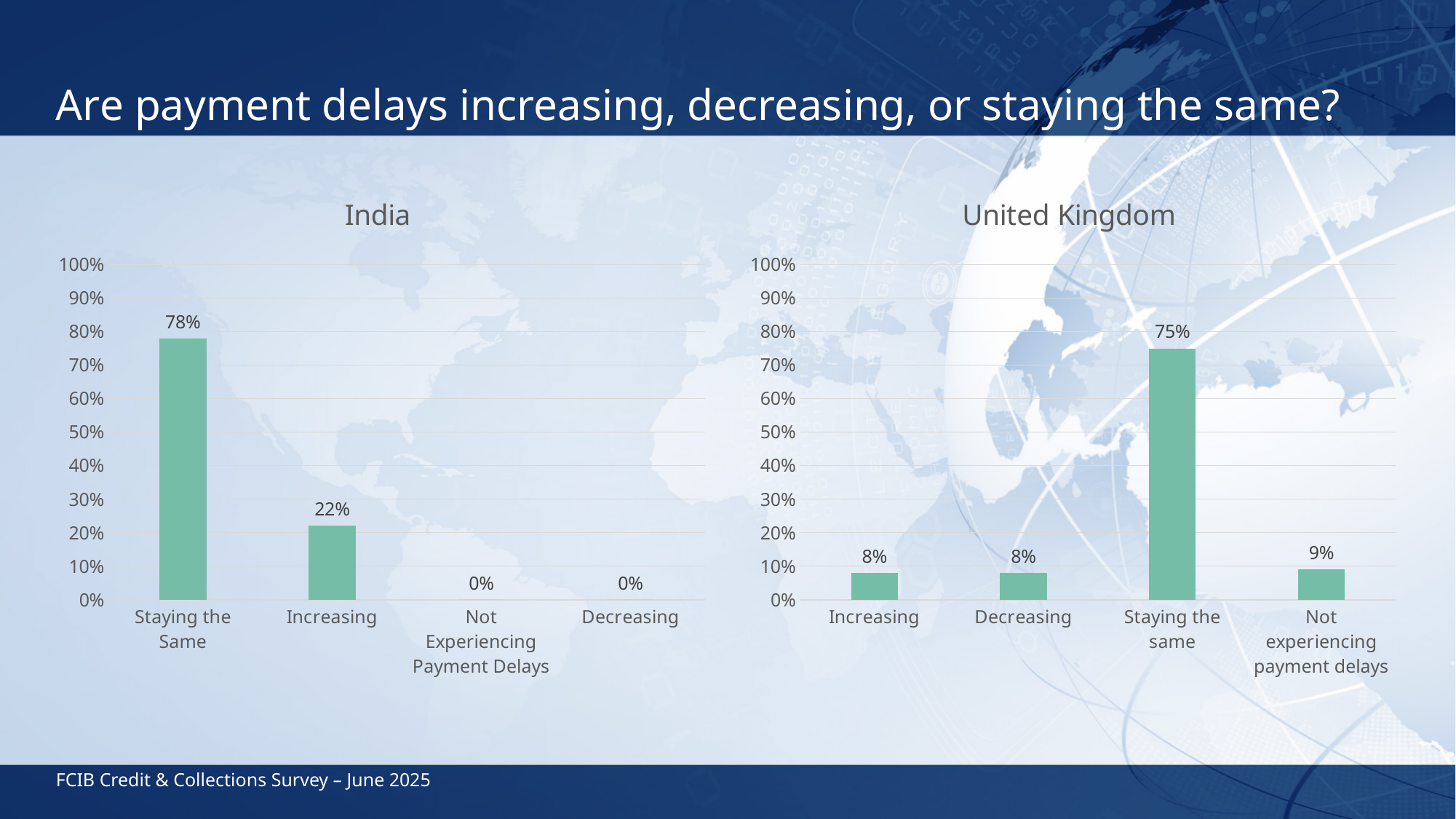
In the India chart, what is the value for Decreasing? 0% In the India chart, what percentage of respondents said payment delays are staying the same? 78% How many categories are shown in the India chart? 4 In the United Kingdom chart, what is the value for Staying the same? 75% What is the title of the chart on the right side of the slide? United Kingdom In the United Kingdom chart, which category has the highest value? Staying the same In the India chart, what is the value for Increasing? 22% In the India chart, what is the difference between Staying the Same and Increasing? 56% In the United Kingdom chart, what is the value for Not experiencing payment delays? 9% In the United Kingdom chart, what is the difference between Staying the same and Not experiencing payment delays? 66% Which is larger: the Increasing value in the India chart or the Increasing value in the United Kingdom chart? India What kind of chart is the United Kingdom chart? Bar chart